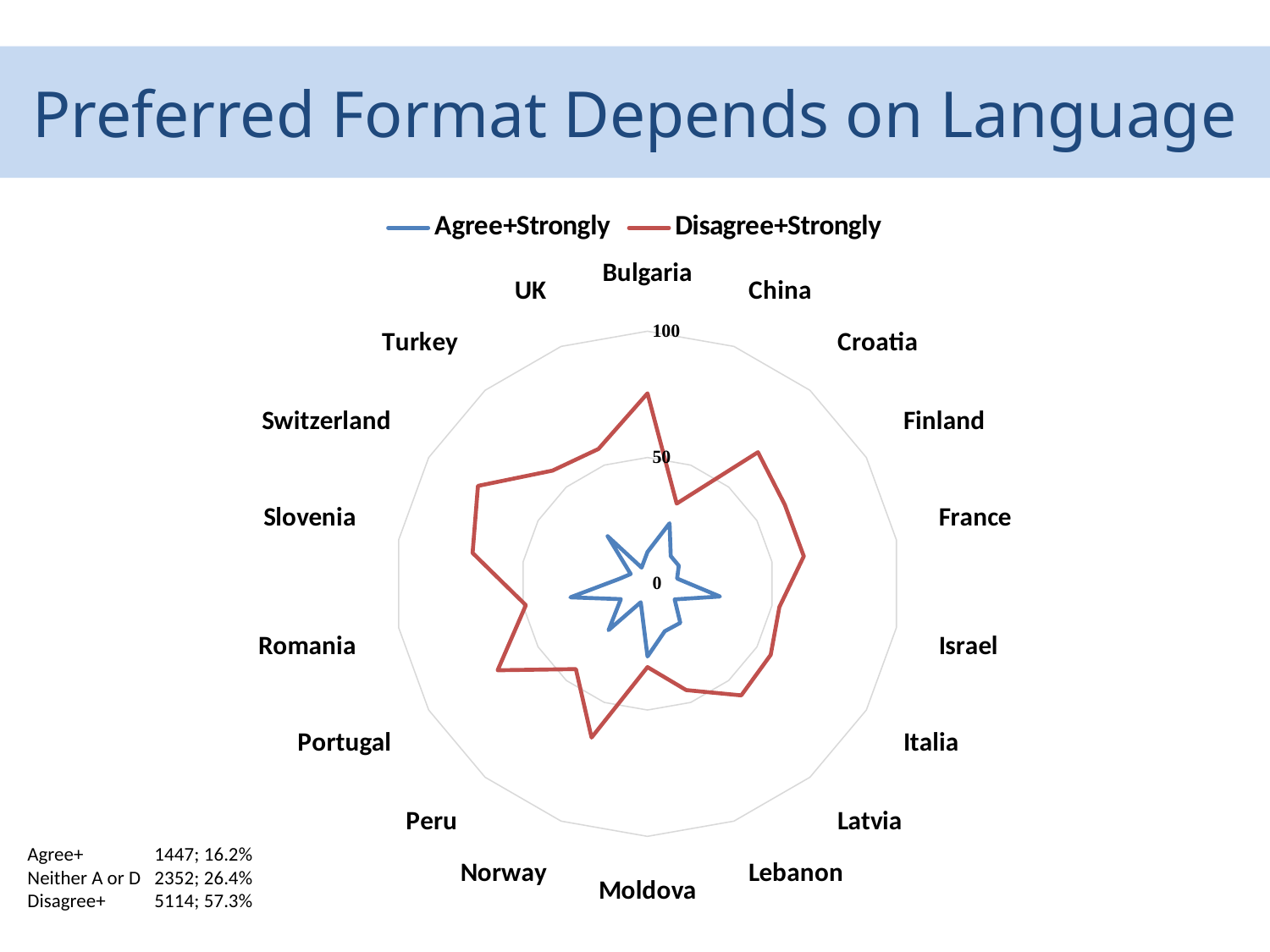
Is the Disagree+Strongly value for Bulgaria greater or less than 50? greater What kind of chart is shown on the slide? Radar chart Is the Disagree+Strongly value for Moldova greater or less than 50? less For France, which series has the larger value: Agree+Strongly or Disagree+Strongly? Disagree+Strongly Which is larger for Bulgaria: the Disagree+Strongly value or the Disagree+Strongly value for China? Bulgaria What is the title of the slide containing the chart? Preferred Format Depends on Language How many countries are plotted around the radar chart? 18 Is the Agree+Strongly value for Bulgaria greater or less than 50? less How many series does the chart's legend list? 2 What are the two series named in the legend? Agree+Strongly and Disagree+Strongly